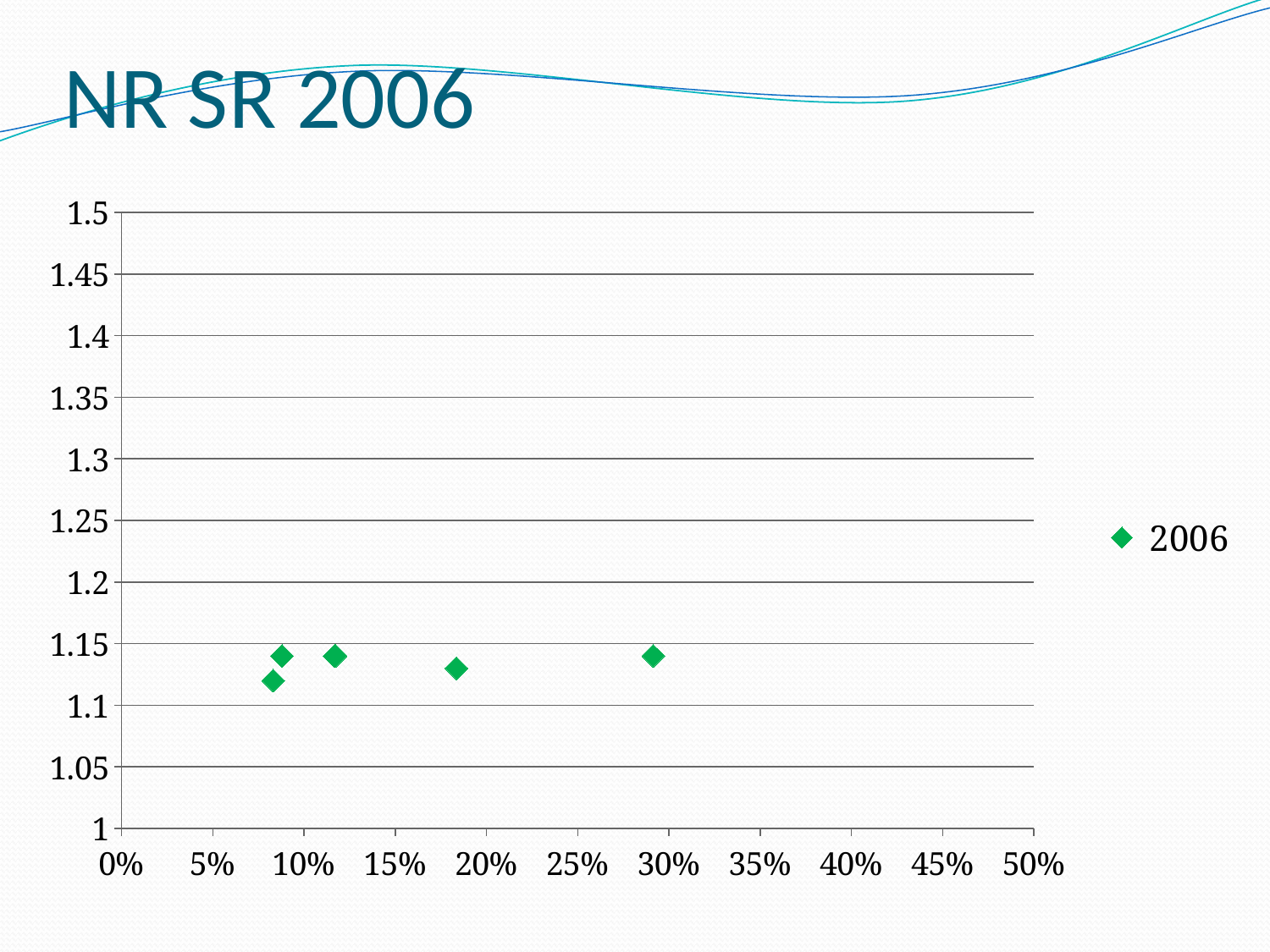
Is the value of the point nearest 20% on the x axis greater or less than 1.15? less How many series does the legend list? 1 What is the title of the slide containing the chart? NR SR 2006 What kind of chart is shown on the slide? scatter chart Are any points plotted beyond 35% on the x axis? no What is the maximum value shown on the y axis? 1.5 Do the plotted values rise strongly, fall strongly, or stay roughly flat as the x-axis percentage increases? roughly flat Are all plotted points below 1.2 on the y axis? yes What is the legend entry for the plotted series? 2006